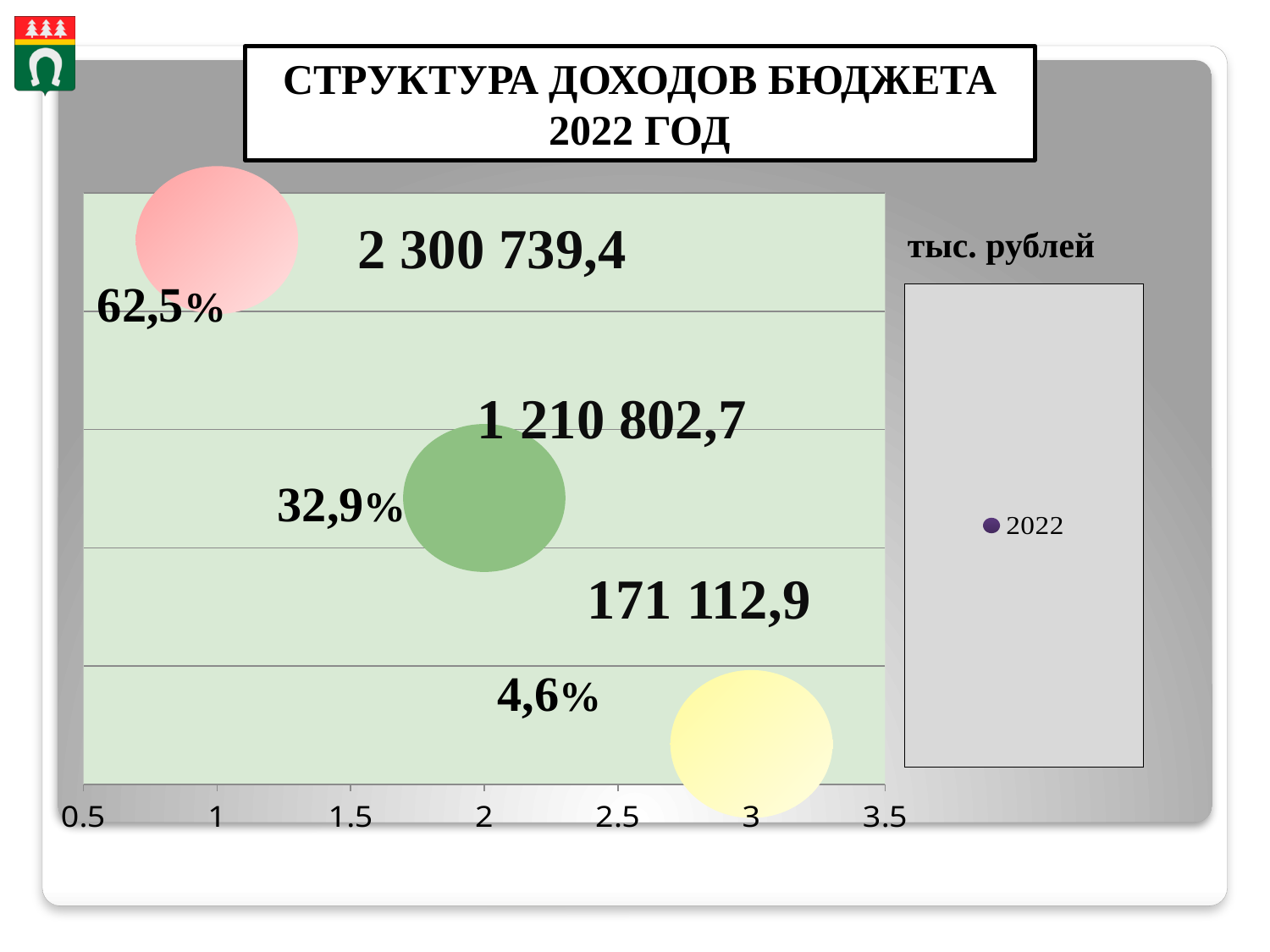
How many bubbles are plotted on the chart? 3 What percentage share is labelled for the yellow bubble? 4,6% Which bubble has the largest labelled value? the pink bubble (2 300 739,4) What is the title of the chart? СТРУКТУРА ДОХОДОВ БЮДЖЕТА 2022 ГОД What value is labelled next to the pink bubble at x = 1? 2 300 739,4 What percentage share is labelled for the pink bubble? 62,5% What value is labelled next to the yellow bubble at x = 3? 171 112,9 What type of chart is shown on the slide? bubble chart What series name is shown in the legend? 2022 How many series does the legend list? 1 Which bubble has the smallest labelled value? the yellow bubble (171 112,9) What value is labelled next to the green bubble at x = 2? 1 210 802,7